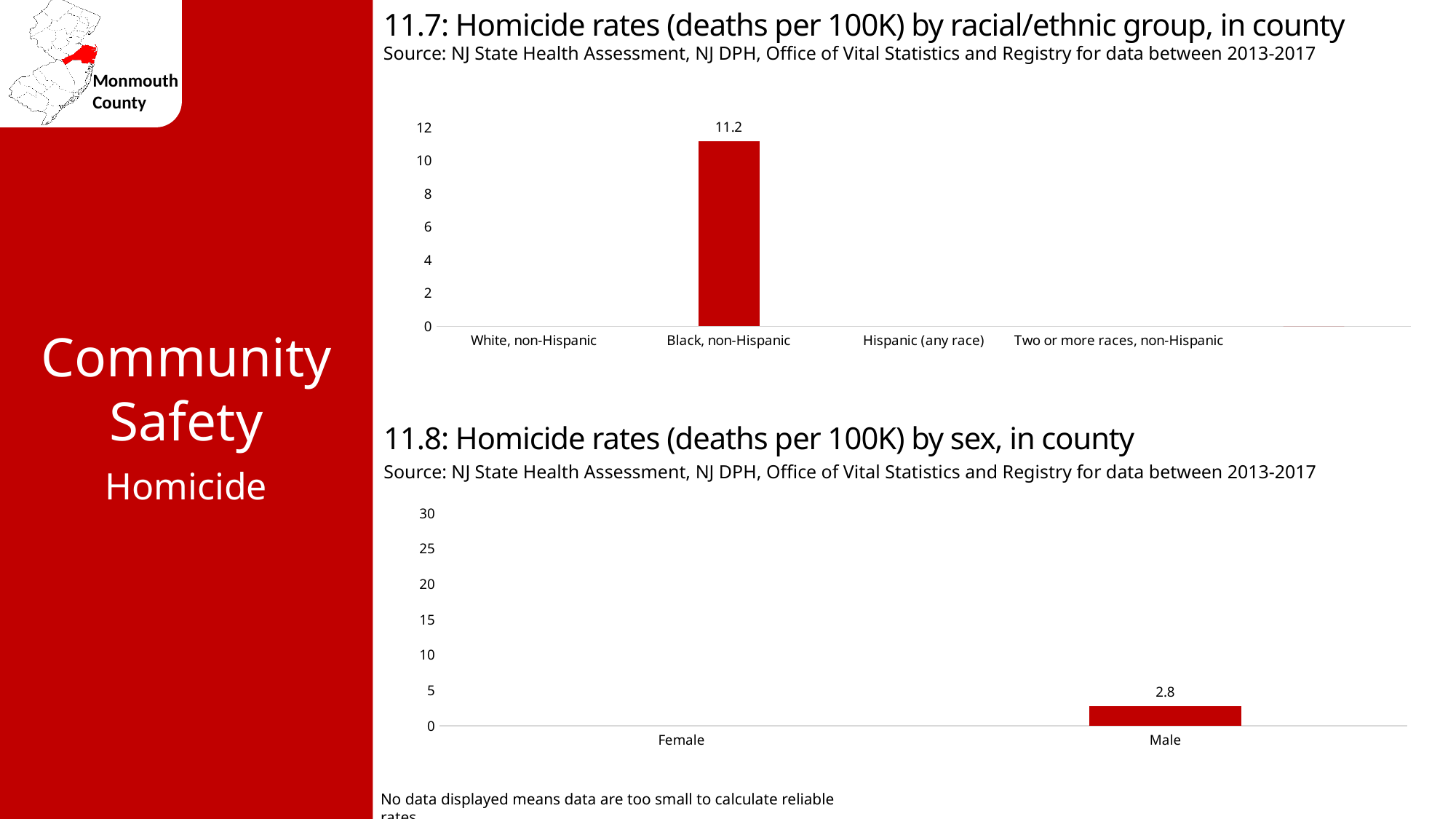
Which is larger: the Black, non-Hispanic rate in chart 11.7 or the Male rate in chart 11.8? Black, non-Hispanic rate in chart 11.7 In chart 11.7 (Homicide rates by racial/ethnic group), what kind of chart is shown? Bar chart In chart 11.7 (Homicide rates by racial/ethnic group), how many racial/ethnic group categories are listed on the x axis? 4 In chart 11.8 (Homicide rates by sex), what is the homicide rate for Male? 2.8 In chart 11.8 (Homicide rates by sex), which sex has a homicide rate displayed? Male In chart 11.8 (Homicide rates by sex), what kind of chart is shown? Bar chart In chart 11.7 (Homicide rates by racial/ethnic group), what is the homicide rate for Black, non-Hispanic? 11.2 In chart 11.8 (Homicide rates by sex), how many categories are listed on the x axis? 2 In chart 11.7 (Homicide rates by racial/ethnic group), is the value for Black, non-Hispanic greater or less than 10? greater In chart 11.7 (Homicide rates by racial/ethnic group), which racial/ethnic group has the highest homicide rate shown? Black, non-Hispanic In chart 11.7 (Homicide rates by racial/ethnic group), what is the highest value shown on the y axis? 12 In chart 11.8 (Homicide rates by sex), is the value for Male greater or less than 5? less